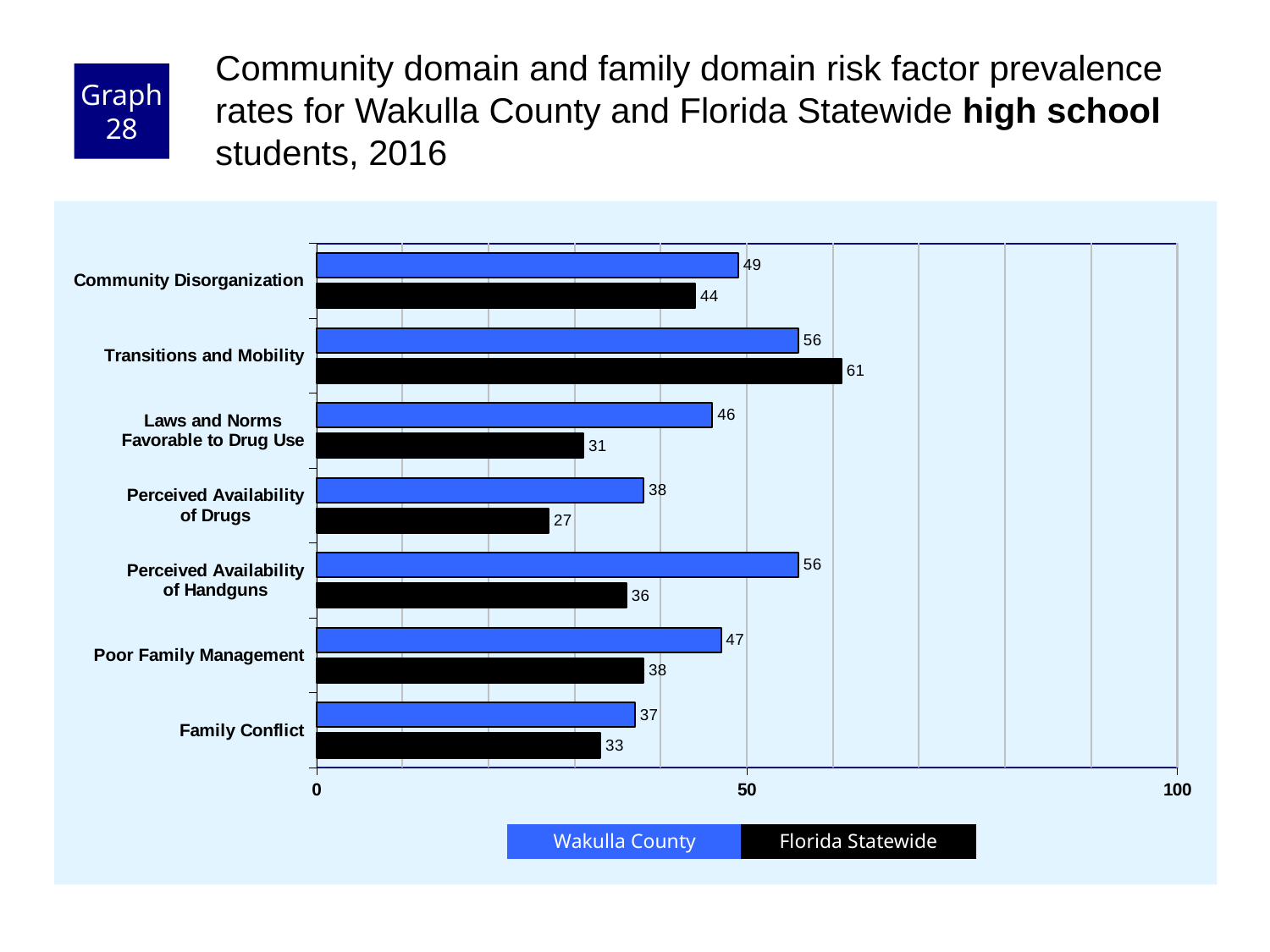
What kind of chart is shown on the slide? bar chart Which category has the highest Florida Statewide value? Transitions and Mobility What is the Wakulla County value for Community Disorganization? 49 What is the difference between the Wakulla County and Florida Statewide values for Perceived Availability of Handguns? 20 How many risk factor categories are shown on the chart? 7 For Transitions and Mobility, which is larger: the Wakulla County value or the Florida Statewide value? Florida Statewide What is the Florida Statewide value for Perceived Availability of Drugs? 27 Which colour represents Florida Statewide in the chart? black Which category has the lowest Wakulla County value? Family Conflict What is the Florida Statewide value for Transitions and Mobility? 61 Is the Wakulla County value for Poor Family Management greater or less than 50? less How many series does the legend list? 2